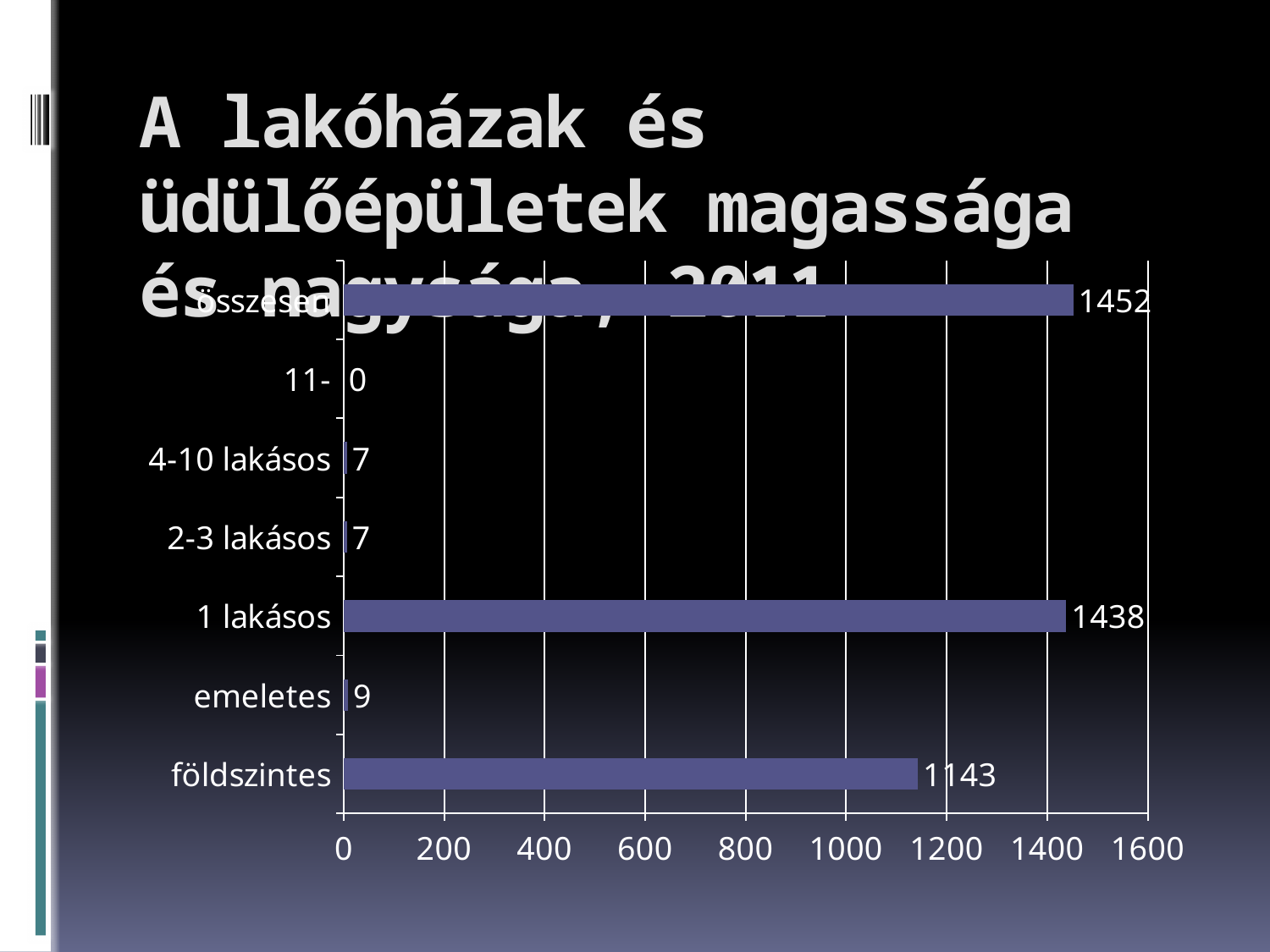
What is the value for 4-10 lakásos? 7 How many categories are shown on the chart? 7 Is the value for földszintes greater or less than 1200? less What is the value for emeletes? 9 What is the value for földszintes? 1143 What is the value for 11-? 0 Which category has the highest value? összesen Which is larger, the value for emeletes or the value for 2-3 lakásos? emeletes What is the value for 1 lakásos? 1438 What kind of chart is shown on the slide? bar chart What is the difference between the values for 1 lakásos and földszintes? 295 Which category has the lowest value? 11-